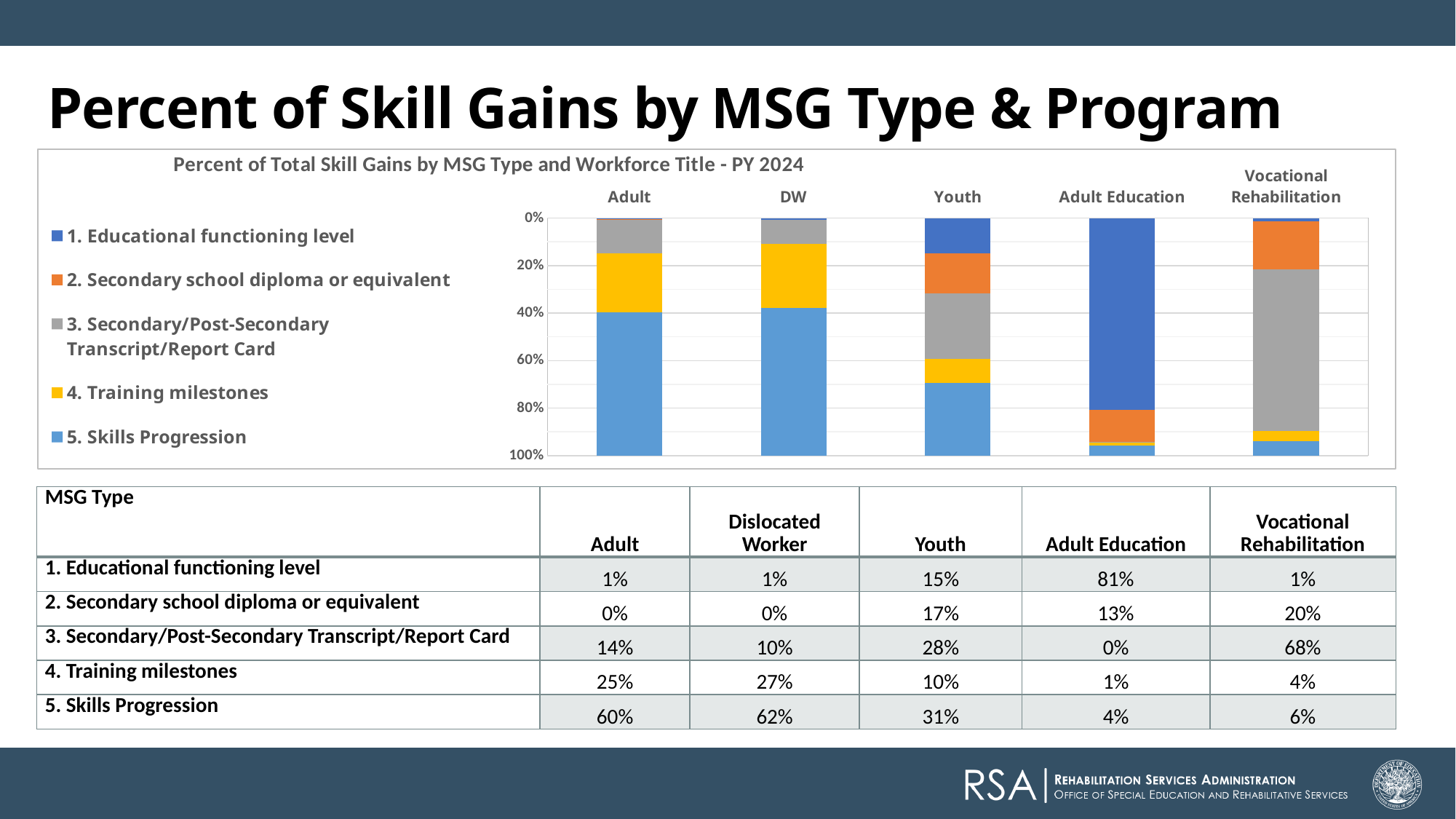
What is the Educational functioning level value for Adult Education? 81% Which program has the lowest Skills Progression share? Adult Education Which program has the highest Secondary/Post-Secondary Transcript/Report Card share? Vocational Rehabilitation What is the difference between the Training milestones values for Dislocated Worker and Adult? 2% What is the Skills Progression value for the Adult program? 60% How many series does the chart's legend list? 5 What is the title of the chart? Percent of Total Skill Gains by MSG Type and Workforce Title - PY 2024 What is the Secondary school diploma or equivalent value for Vocational Rehabilitation? 20% What kind of chart is shown on the slide? Stacked bar chart Is the Skills Progression value for the Adult program greater or less than 40%? greater For Youth, which is larger: Educational functioning level or Secondary school diploma or equivalent? Secondary school diploma or equivalent How many program categories are plotted along the x axis of the chart? 5